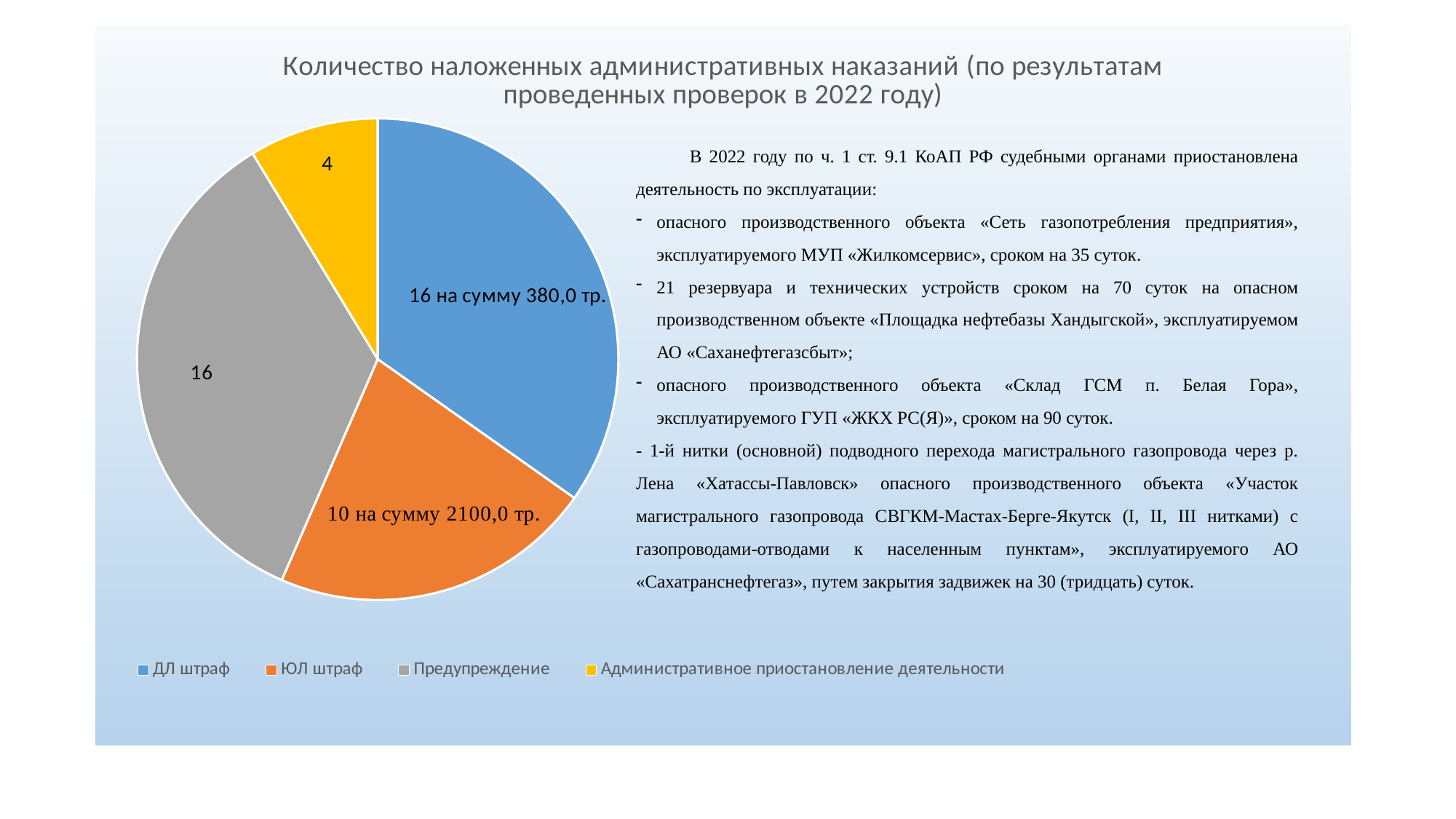
What type of chart is shown on the slide? pie chart What is the value shown for the Предупреждение slice? 16 What colour is the Предупреждение slice in the pie chart? grey Which category has the smallest slice in the pie chart? Административное приостановление деятельности What is the difference between the number of ЮЛ штраф and the number of Административное приостановление деятельности? 6 What is the value shown for the ДЛ штраф slice? 16 на сумму 380,0 тр. What is the total number of administrative penalties across all slices of the pie chart? 46 How many entries does the legend of the pie chart list? 4 What is the value shown for the ЮЛ штраф slice? 10 на сумму 2100,0 тр. What is the value shown for the Административное приостановление деятельности slice? 4 Which is larger: the count for ЮЛ штраф or the count for Предупреждение? Предупреждение How many slices does the pie chart have? 4